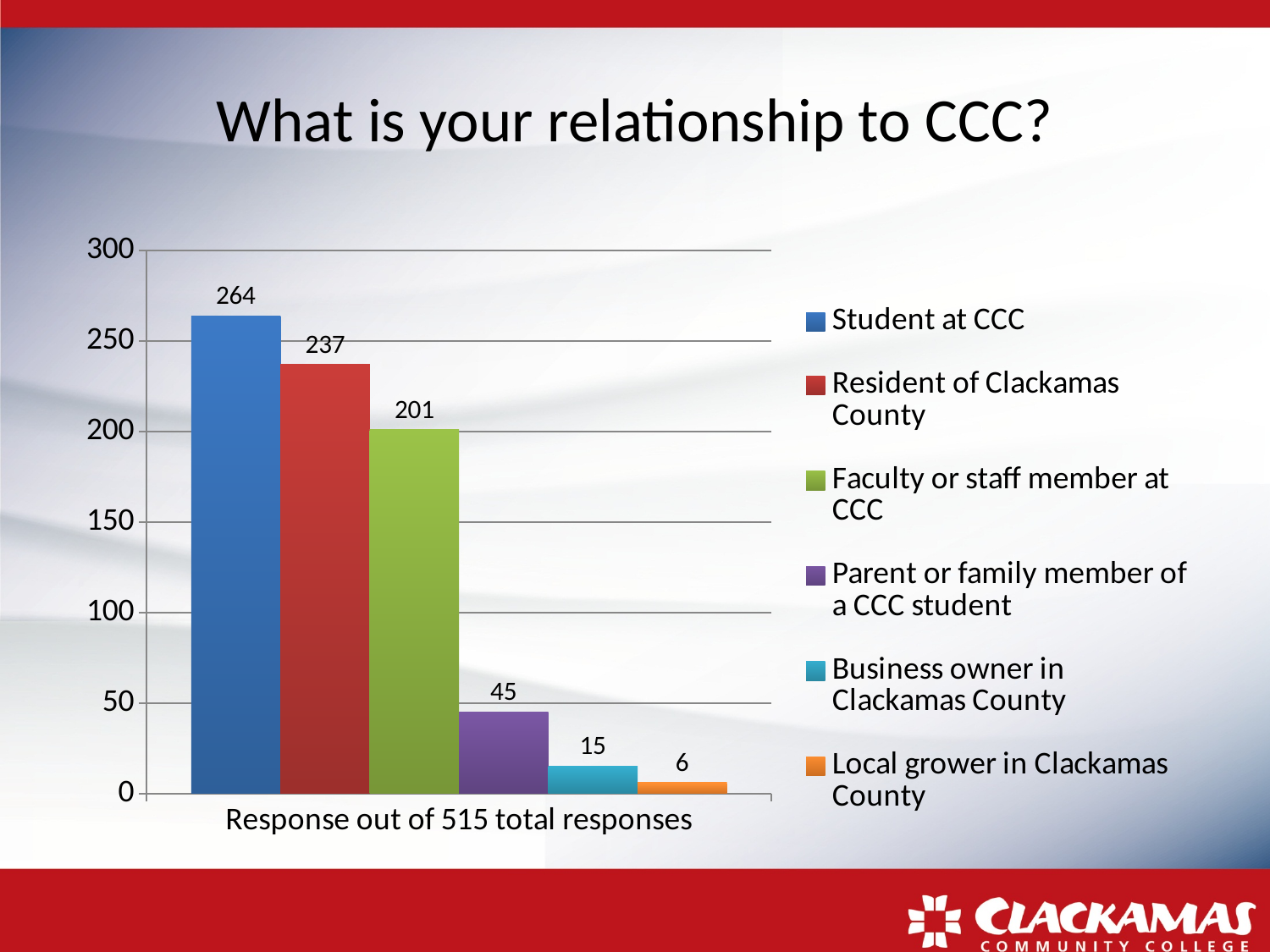
Which is larger, the value for Faculty or staff member at CCC or the value for Parent or family member of a CCC student? Faculty or staff member at CCC Which category has the highest value? Student at CCC How many series does the legend list? 6 How many respondents were faculty or staff members at CCC? 201 How many responses were from students at CCC? 264 What is the difference between the values for Parent or family member of a CCC student and Business owner in Clackamas County? 30 What is the value for Local grower in Clackamas County? 6 What is the difference between the values for Student at CCC and Resident of Clackamas County? 27 Which category has the lowest value? Local grower in Clackamas County What is the label shown below the x axis of the chart? Response out of 515 total responses What kind of chart is shown on the slide? Bar chart What is the value for Resident of Clackamas County? 237